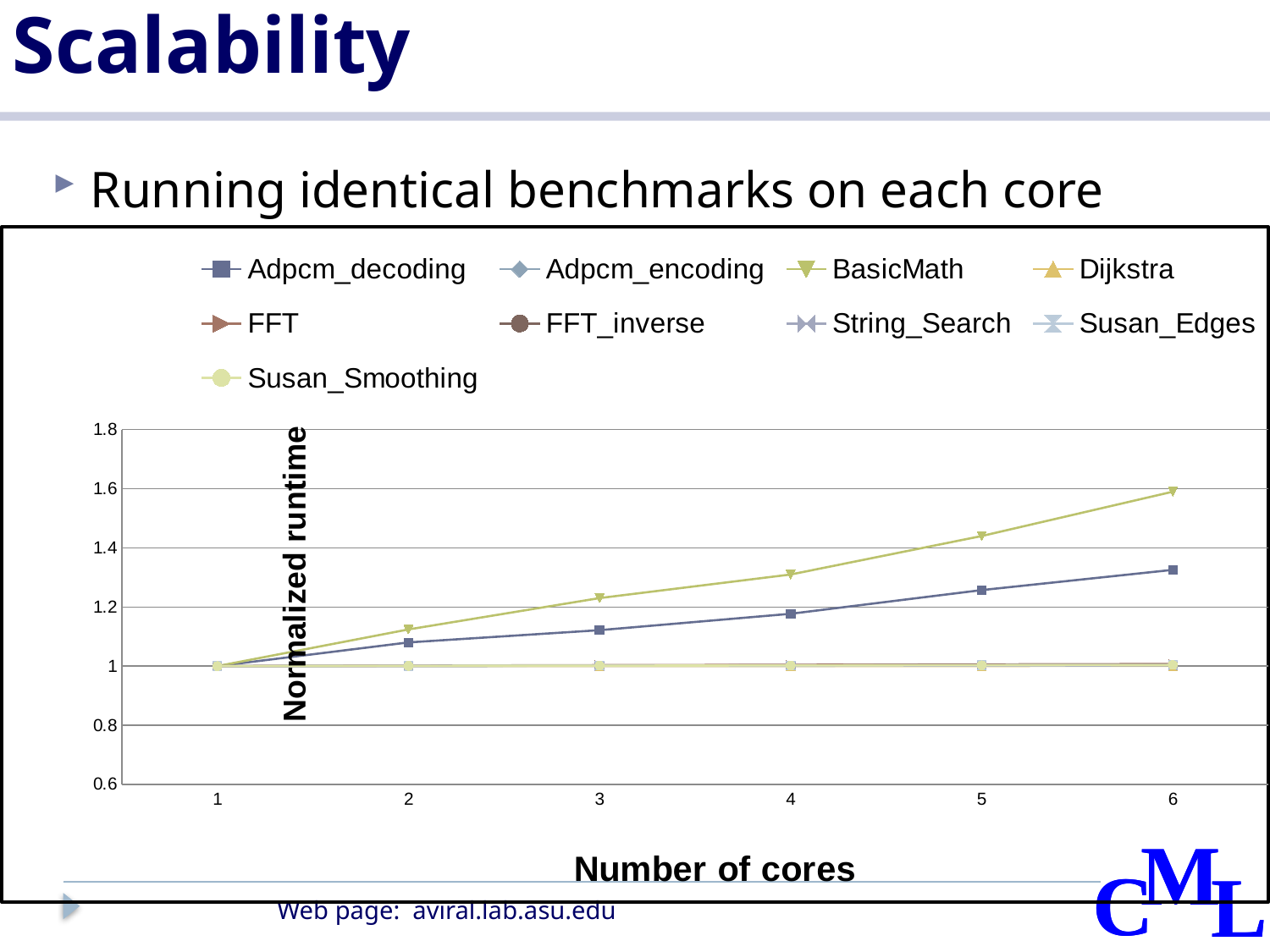
How many core counts are plotted along the x axis? 6 What is the y-axis title of the chart? Normalized runtime At 6 cores, which has the larger normalized runtime, BasicMath or Adpcm_decoding? BasicMath How many series does the legend list? 9 Does the normalized runtime for BasicMath rise or fall as the number of cores increases? rise Is the normalized runtime for Adpcm_decoding at 6 cores greater or less than 1.4? less What kind of chart is shown on the slide? line chart What is the normalized runtime for BasicMath at 1 core? 1 Is the normalized runtime for BasicMath at 6 cores greater or less than 1.4? greater What is the x-axis title of the chart? Number of cores Is the normalized runtime for Adpcm_decoding at 6 cores greater or less than 1.2? greater Which series has the highest normalized runtime at 6 cores? BasicMath